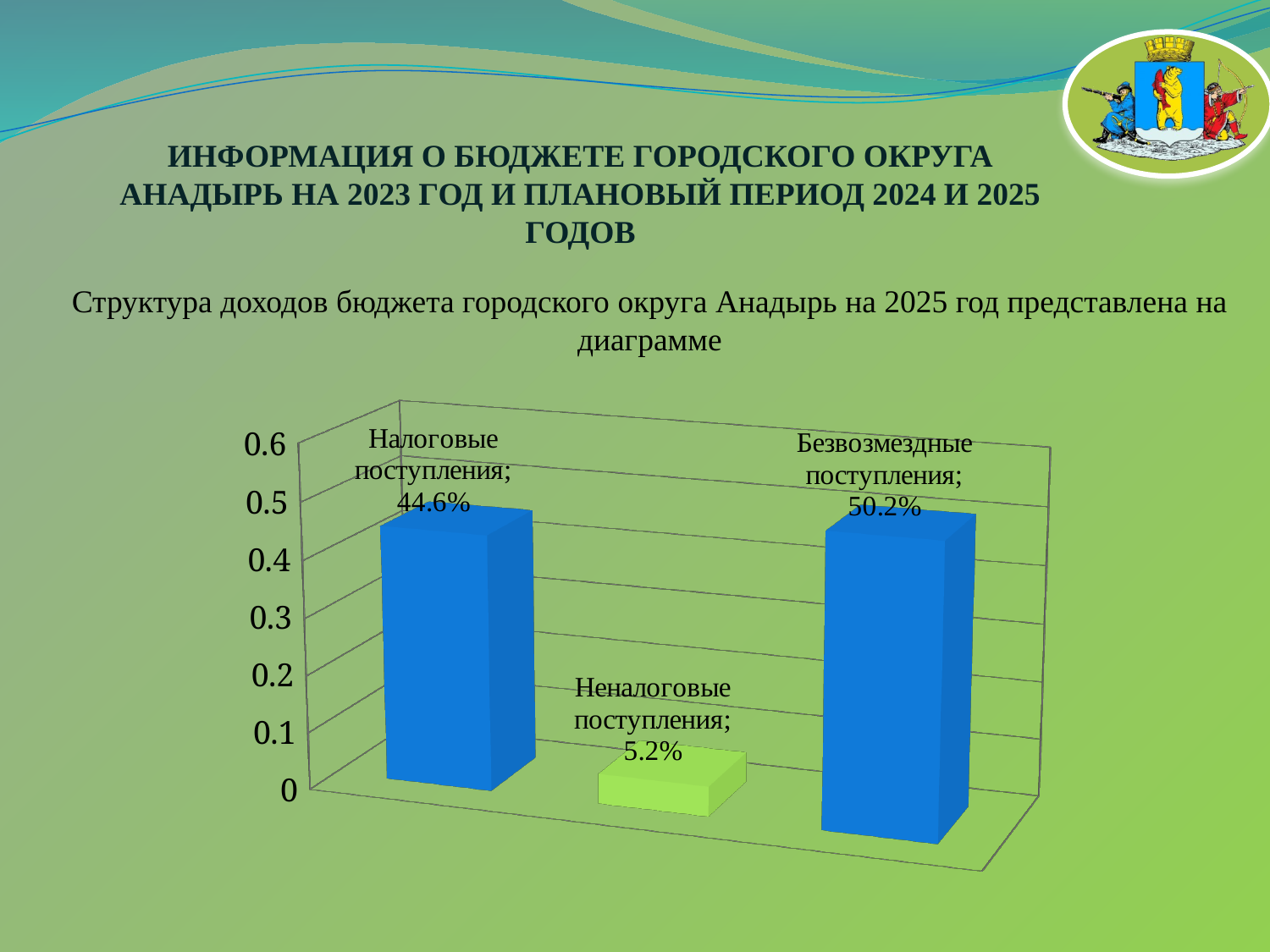
What is the value for Налоговые поступления? 44.6% Which is larger, Налоговые поступления or Безвозмездные поступления? Безвозмездные поступления What kind of chart is shown on the slide? bar chart What is the difference between Безвозмездные поступления and Налоговые поступления? 5.6% Is the value for Налоговые поступления greater or less than 0.5? less Which category has the highest value? Безвозмездные поступления What is the value for Неналоговые поступления? 5.2% What is the difference between Налоговые поступления and Неналоговые поступления? 39.4% What is the highest tick value shown on the vertical axis? 0.6 Which category has the lowest value? Неналоговые поступления What is the value for Безвозмездные поступления? 50.2% How many categories are shown in the chart? 3